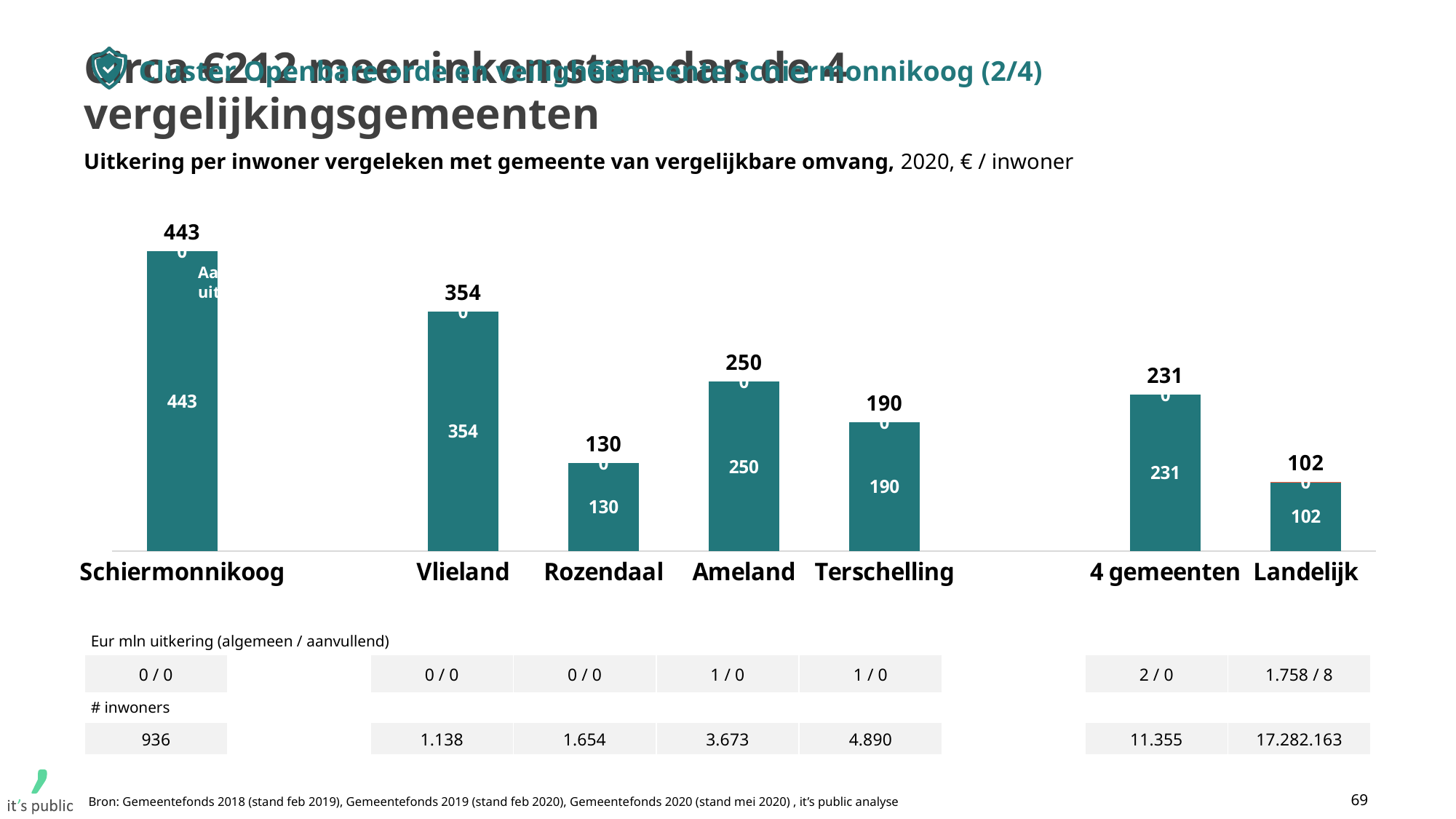
What is the difference between the values for Ameland and Rozendaal? 120 What is the value for Terschelling? 190 How many categories are shown in the chart? 7 What is the value for Schiermonnikoog? 443 Which category has the highest value? Schiermonnikoog What unit is stated in the chart subtitle for the plotted values? € / inwoner Which category has the lowest value? Landelijk Which is larger, the value for Vlieland or the value for Ameland? Vlieland What is the difference between the values for Schiermonnikoog and 4 gemeenten? 212 What kind of chart is shown on the slide? Bar chart What is the value for Vlieland? 354 What is the value for Landelijk? 102